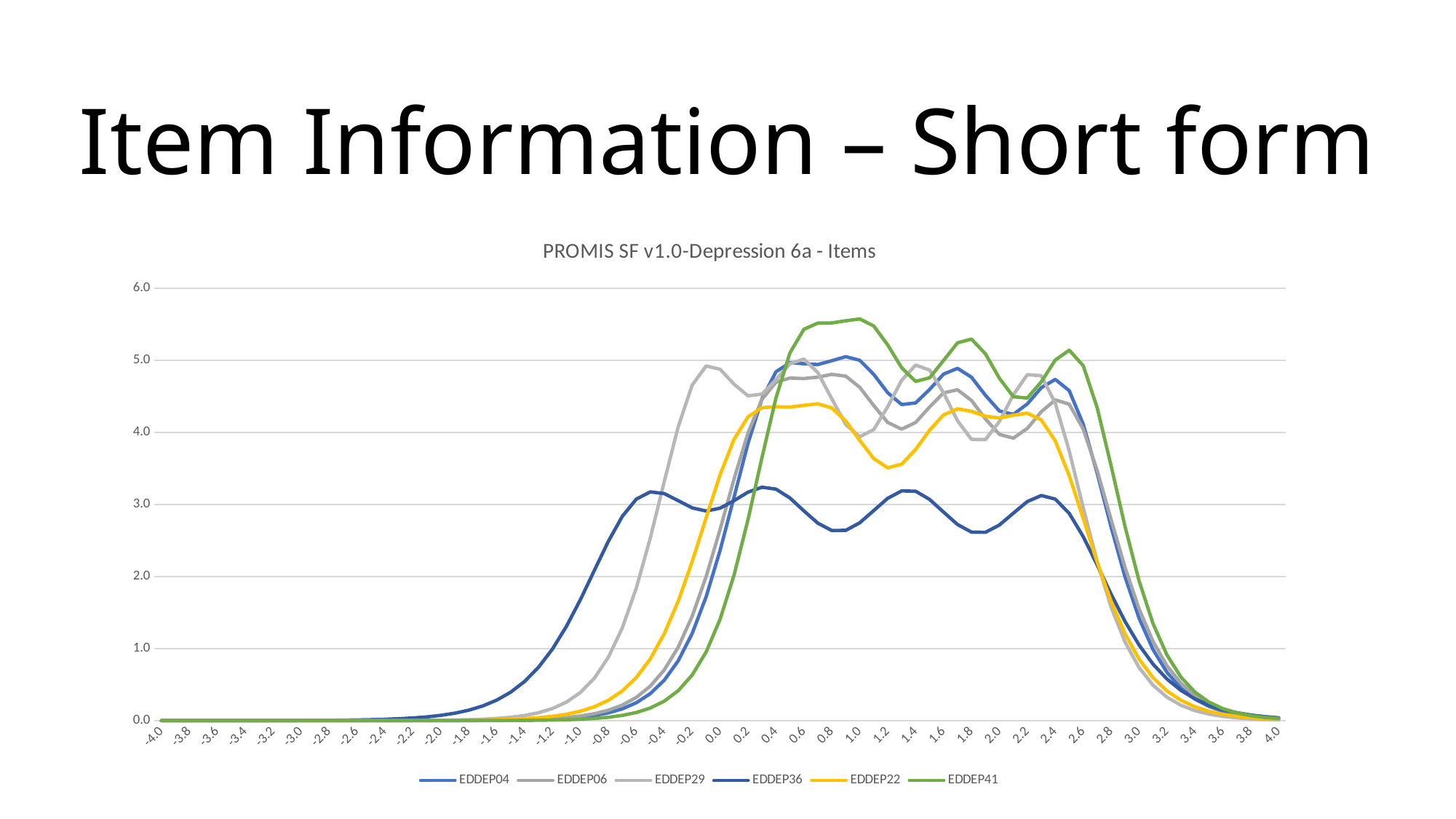
What is the title of the chart? PROMIS SF v1.0-Depression 6a - Items Is the value for EDDEP36 at x = -0.8 greater or less than 2.0? greater Which series reaches the highest peak value on the chart? EDDEP41 Which series has the lowest peak value on the chart? EDDEP36 At x = -0.6, which series has the larger value, EDDEP36 or EDDEP41? EDDEP36 Is the value for EDDEP36 at x = 1.0 greater or less than 3.0? less Does the EDDEP41 series rise or fall between x = 2.6 and x = 4.0? fall What kind of chart is shown on the slide? line chart Which colour is used for the EDDEP41 series? green Is the value for EDDEP22 at x = 1.2 greater or less than 4.0? less How many series does the legend list? 6